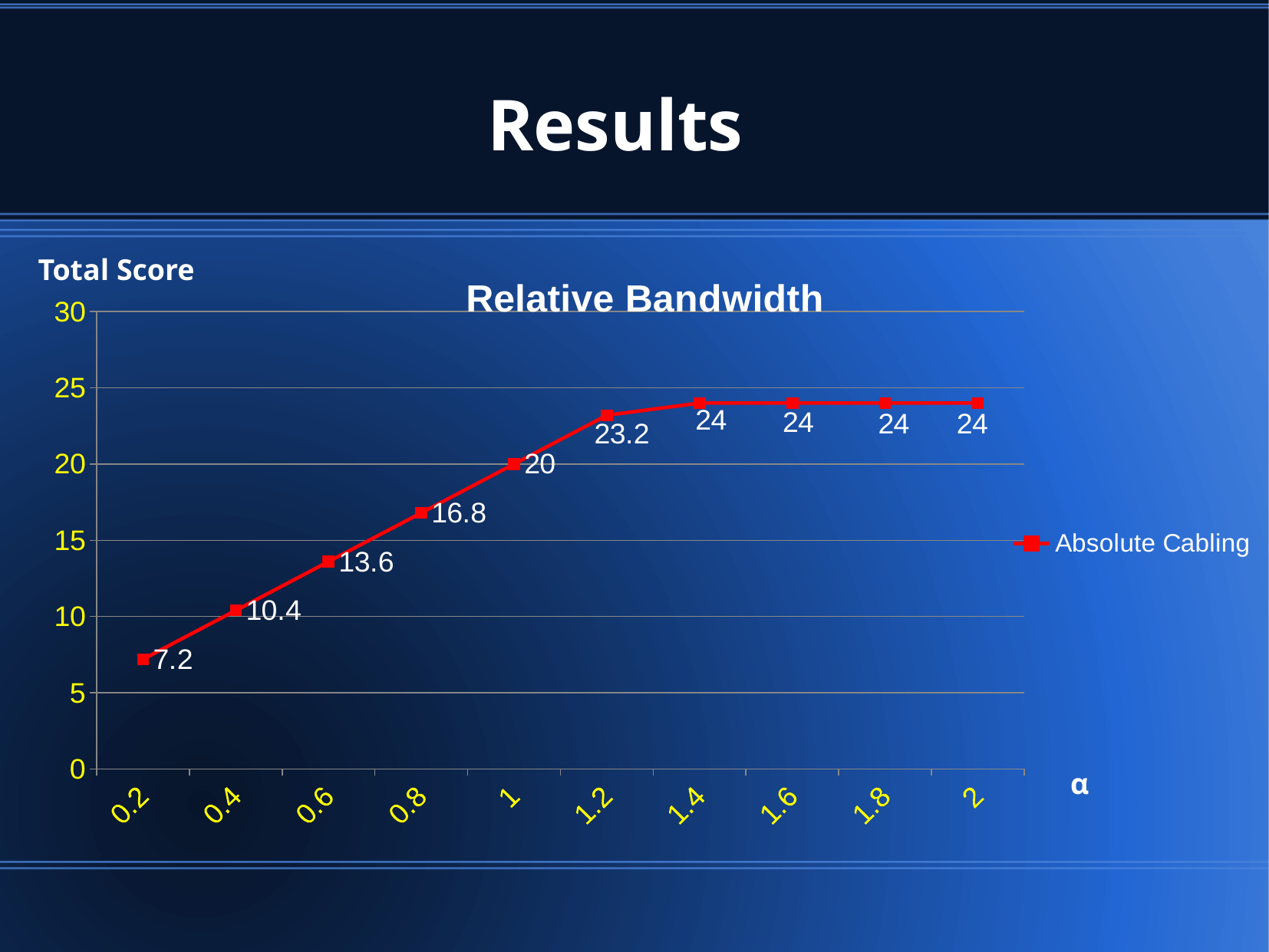
What is the value at α = 0.2? 7.2 Is the value at α = 0.6 greater or less than 15? less What is the difference between the values at α = 1.4 and α = 1.2? 0.8 What is the value at α = 0.8? 16.8 At which α value is the plotted value lowest? 0.2 How many data points are plotted on the chart? 10 What kind of chart is shown on the slide? line chart What is the difference between the values at α = 1 and α = 0.6? 6.4 What is the name of the series shown in the legend? Absolute Cabling What is the value at α = 1? 20 What is the value at α = 1.2? 23.2 Which is larger, the value at α = 0.4 or the value at α = 0.8? 0.8